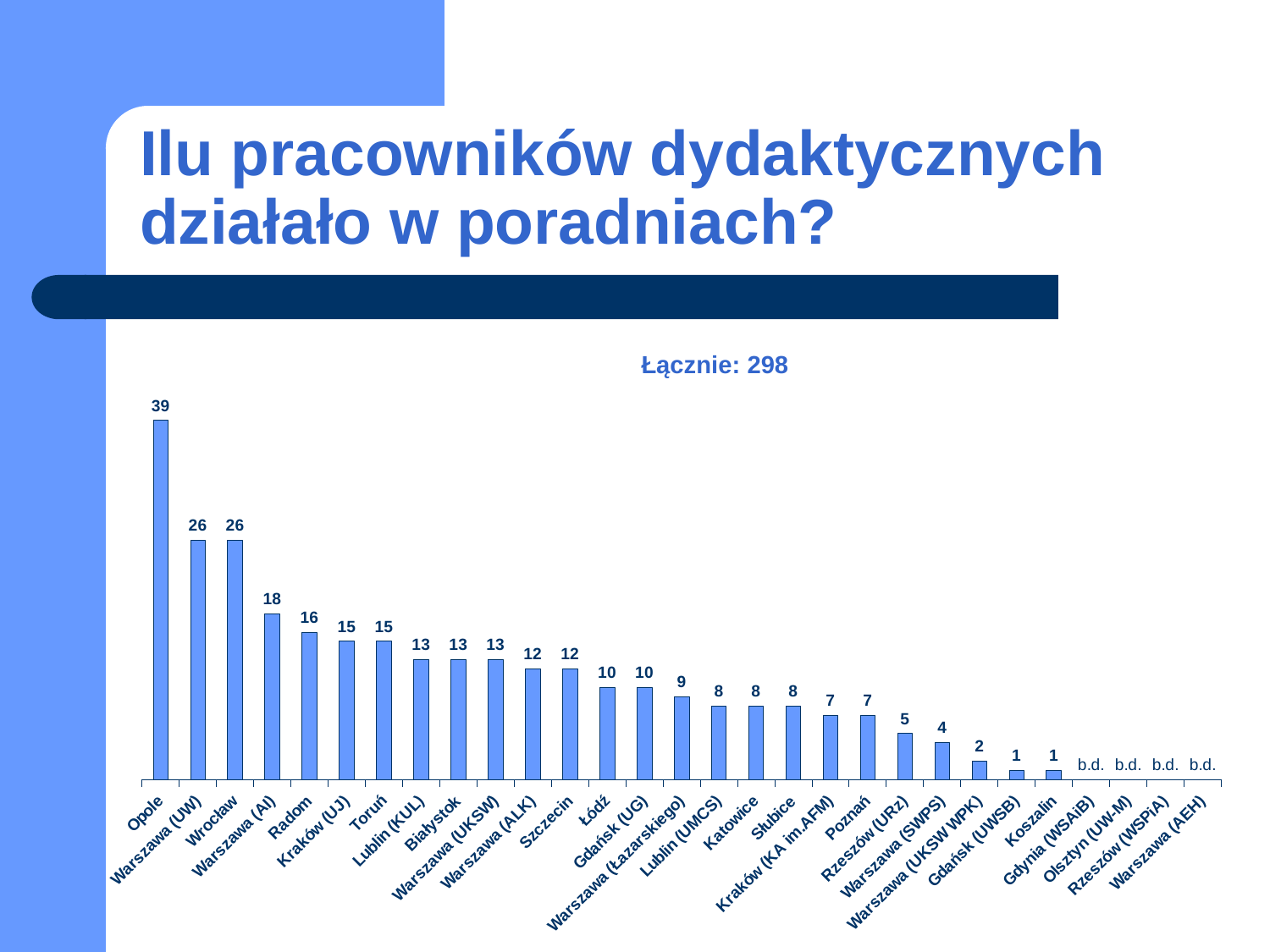
What is the difference between the values for Opole and Wrocław? 13 What kind of chart is shown on the slide? bar chart How many categories are marked 'b.d.' instead of a numeric value? 4 Which is larger, the value for Toruń or the value for Łódź? Toruń How many teaching staff does the chart show for Opole? 39 What is the difference between the values for Warszawa (AI) and Poznań? 11 What value is shown for Szczecin? 12 Which category has the highest value in the chart? Opole What value is shown for Rzeszów (URz)? 5 What value is shown for Radom? 16 What total is stated in the chart's title above the bars? Łącznie: 298 Do the values rise or fall moving from left to right along the x axis? fall